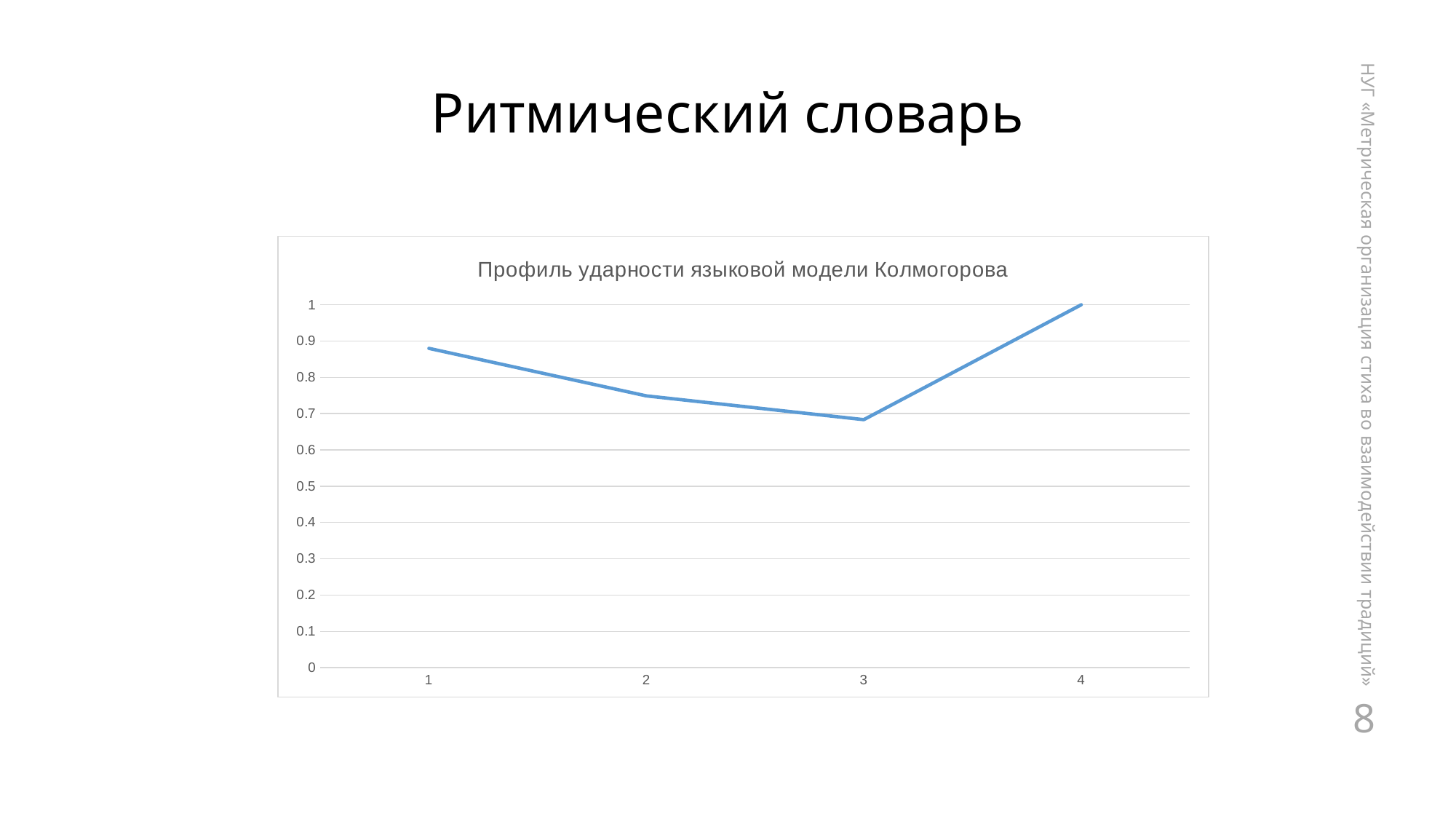
How many points are plotted on the line? 4 What is the value at position 4 on the x axis? 1 At which x-axis position is the value highest? 4 Is the value at position 2 greater or less than 0.8? less What is the title of the chart? Профиль ударности языковой модели Колмогорова At which x-axis position is the value lowest? 3 Is the value at position 3 greater or less than 0.7? less Does the line rise or fall from position 3 to position 4? rise Is the value at position 1 greater or less than 0.8? greater What kind of chart is shown on the slide? line chart Which is larger, the value at position 1 or the value at position 2? position 1 Does the line rise or fall from position 1 to position 3? fall